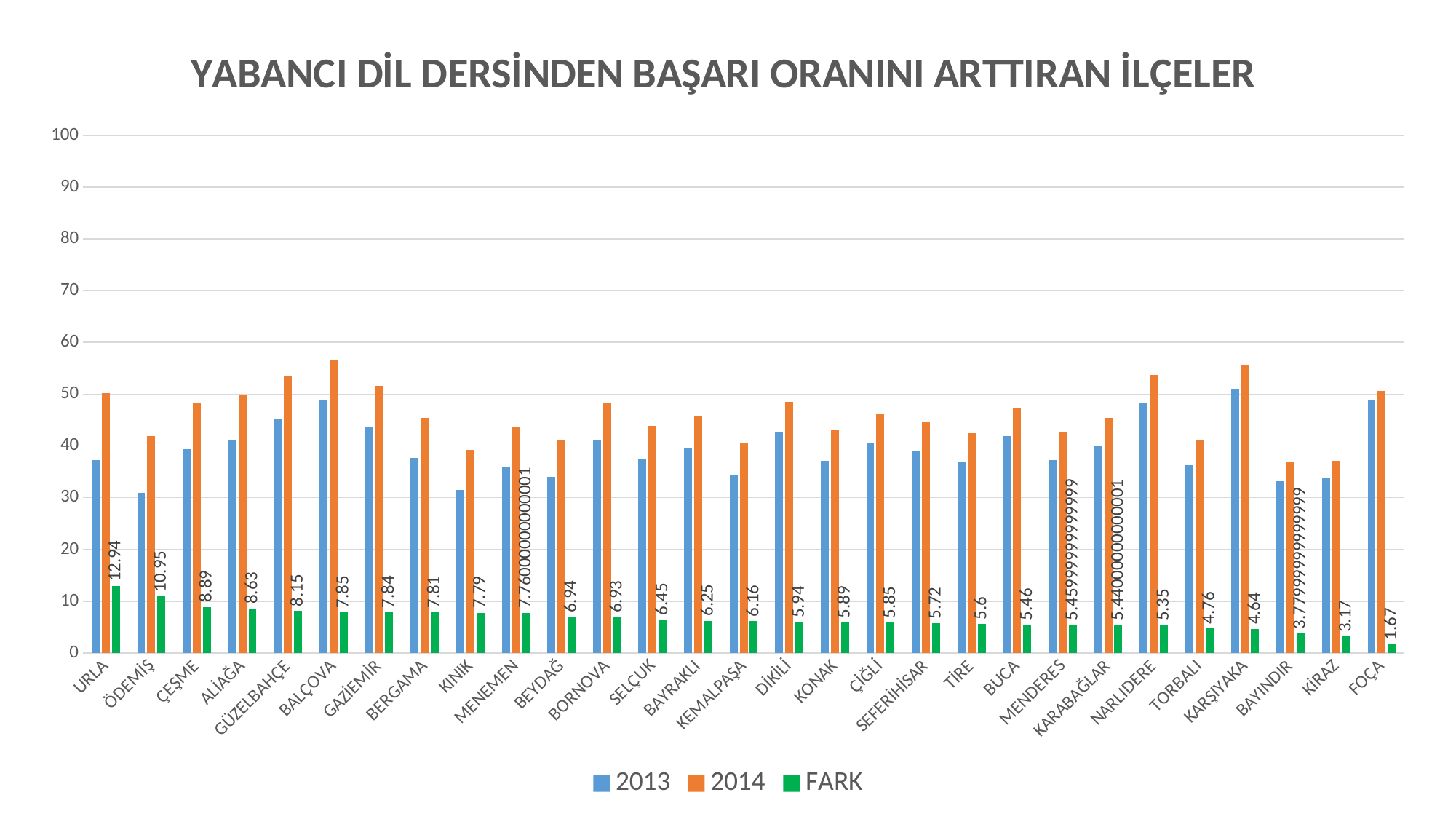
Is the 2014 value for BALÇOVA greater or less than 50? greater What is the FARK value for URLA? 12.94 How many series does the legend list? 3 Which district has the highest FARK value? URLA What is the FARK value for KİRAZ? 3.17 Is the 2013 value for ÖDEMİŞ greater or less than 40? less Which is larger, the 2014 value for BALÇOVA or the 2014 value for KINIK? BALÇOVA What is the difference between the FARK values of URLA and ÖDEMİŞ? 1.99 What kind of chart is shown on the slide? Bar chart How many districts are shown on the x axis? 29 Which district has the lowest FARK value? FOÇA What is the FARK value for TİRE? 5.6